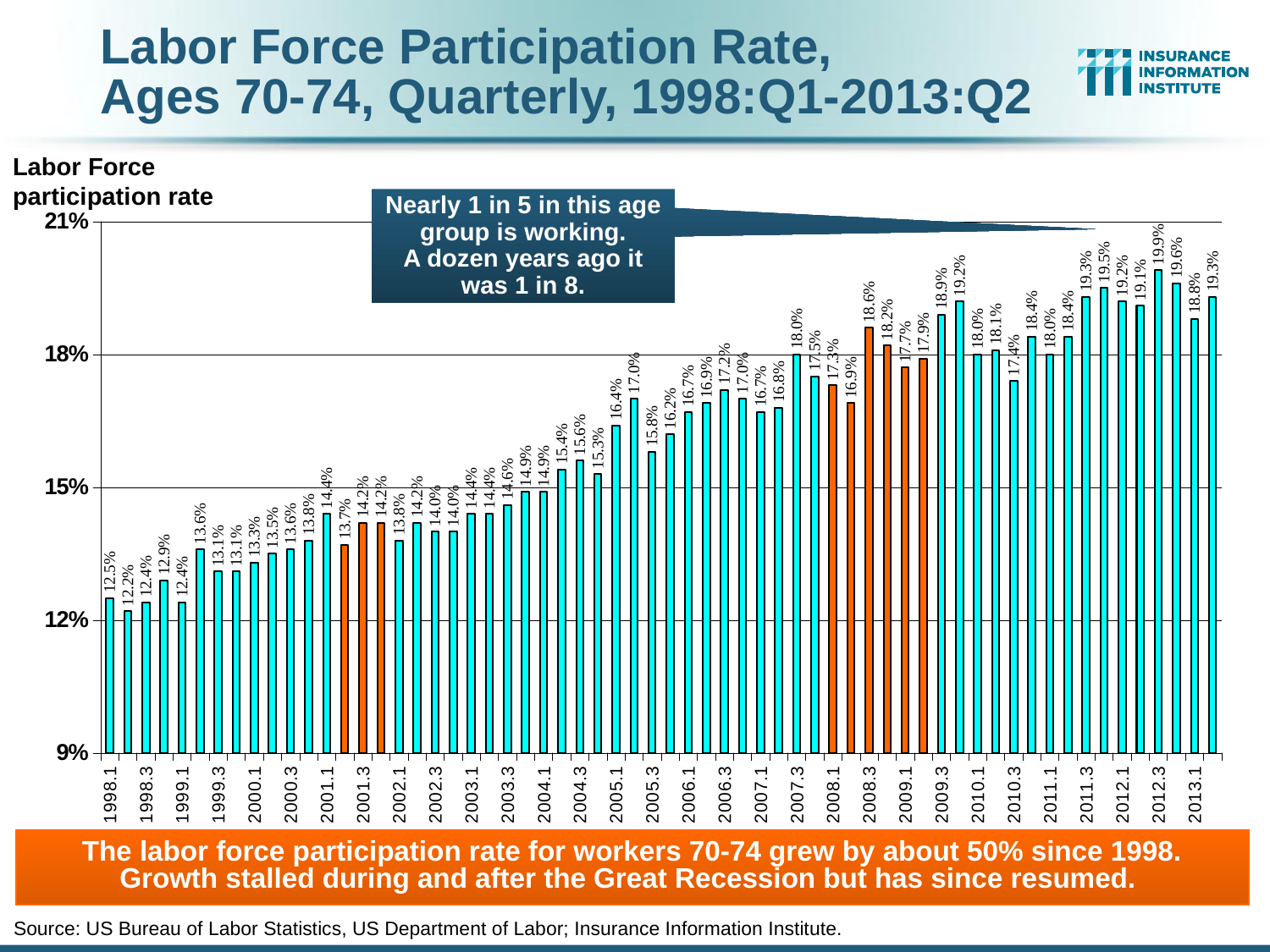
What is the labor force participation rate for 2012.3? 19.9% By how many percentage points did the participation rate in 2013.1 exceed that in 1998.1? 6.3 percentage points What is the labor force participation rate for 1998.1? 12.5% What kind of chart is shown on the slide? Bar chart What is the lowest labor force participation rate shown on the chart? 12.2% Does the labor force participation rate generally rise or fall from 1998 to 2013? Rise What is the labor force participation rate for 2007.3? 18.0% Which quarter has the highest labor force participation rate? 2012.3 Which is higher, the participation rate in 2012.3 or in 2013.1? 2012.3 According to the callout box, what fraction of this age group was working a dozen years ago? 1 in 8 Is the value for 2005.1 greater or less than 15%? greater What is the labor force participation rate for 2013.1? 18.8%